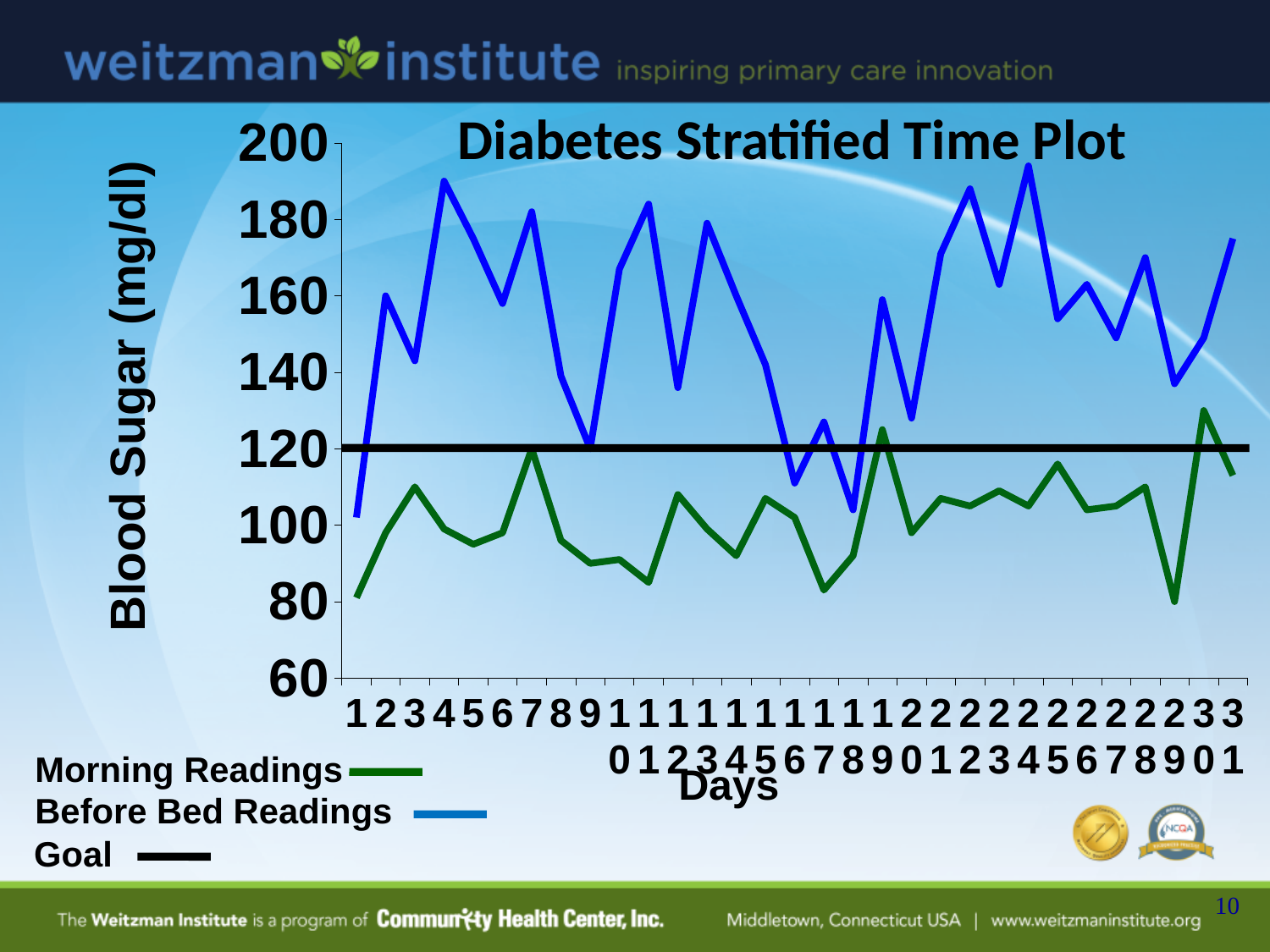
What is the label of the vertical axis? Blood Sugar (mg/dl) Is the Morning Reading on day 30 greater or less than 120? greater Is the Morning Reading on day 1 greater or less than 100? less Is the Before Bed Reading on day 4 greater or less than 180? greater How many days are plotted along the x axis? 31 What kind of chart is shown on the slide? line chart What is the title of the chart? Diabetes Stratified Time Plot On day 4, which is higher, the Morning Reading or the Before Bed Reading? Before Bed Reading How many series does the legend list? 3 What value does the Goal line sit at? 120